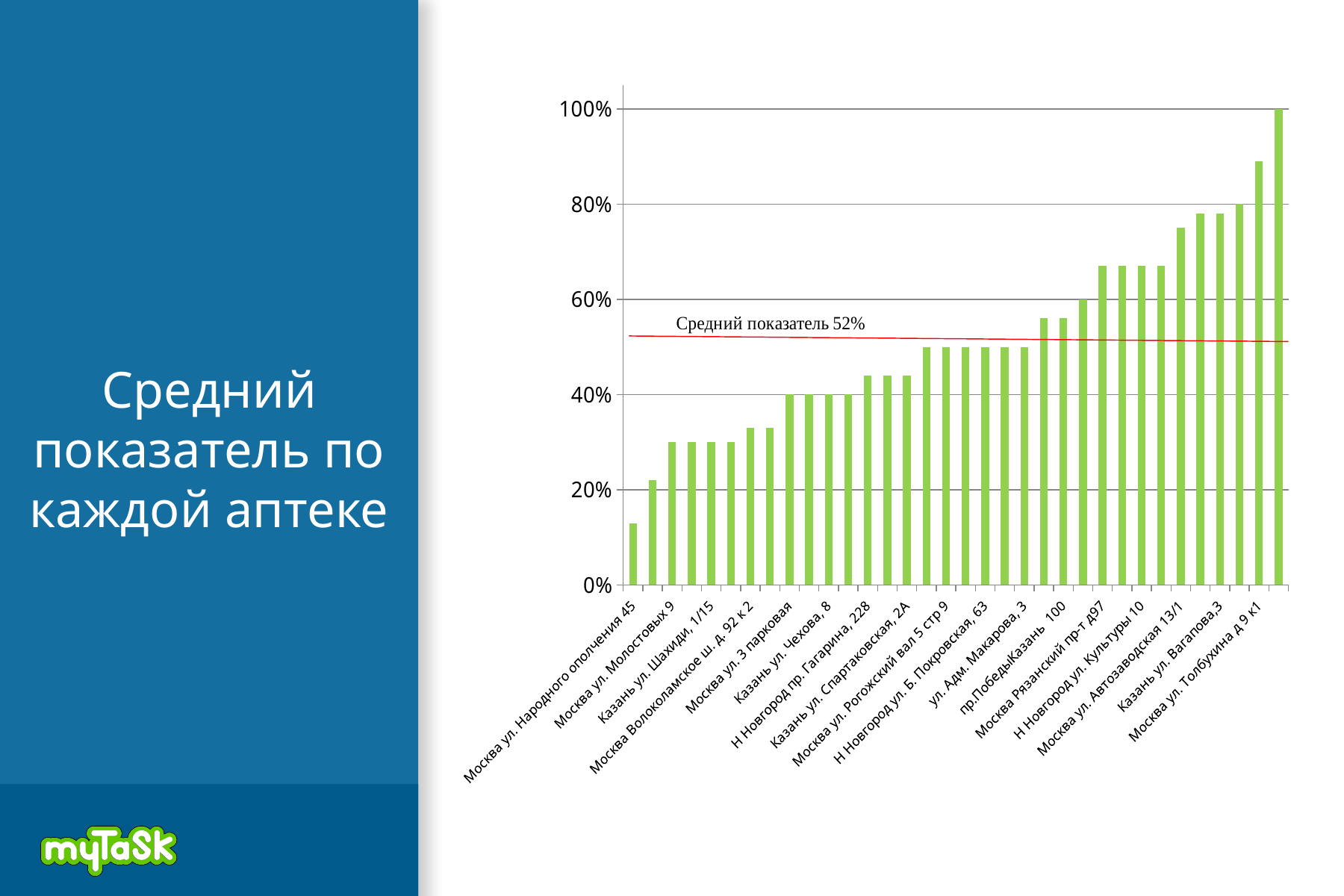
What is the value of the tallest bar on the chart? 100% What is the average value (Средний показатель) marked by the red line on the chart? 52% Do the bar values rise or fall from left to right along the x axis? rise Which pharmacy has the lowest value on the chart? Москва ул. Народного ополчения 45 Is the value for Казань ул. Вагапова,3 greater or less than 60%? greater Is the value for Москва ул. Толбухина д 9 к1 greater or less than 80%? greater Is the value for Н Новгород пр. Гагарина, 228 greater or less than 40%? greater What is the title of the slide? Средний показатель по каждой аптеке What kind of chart is shown on the slide? bar chart Which has a larger value: Москва ул. Толбухина д 9 к1 or Москва ул. Народного ополчения 45? Москва ул. Толбухина д 9 к1